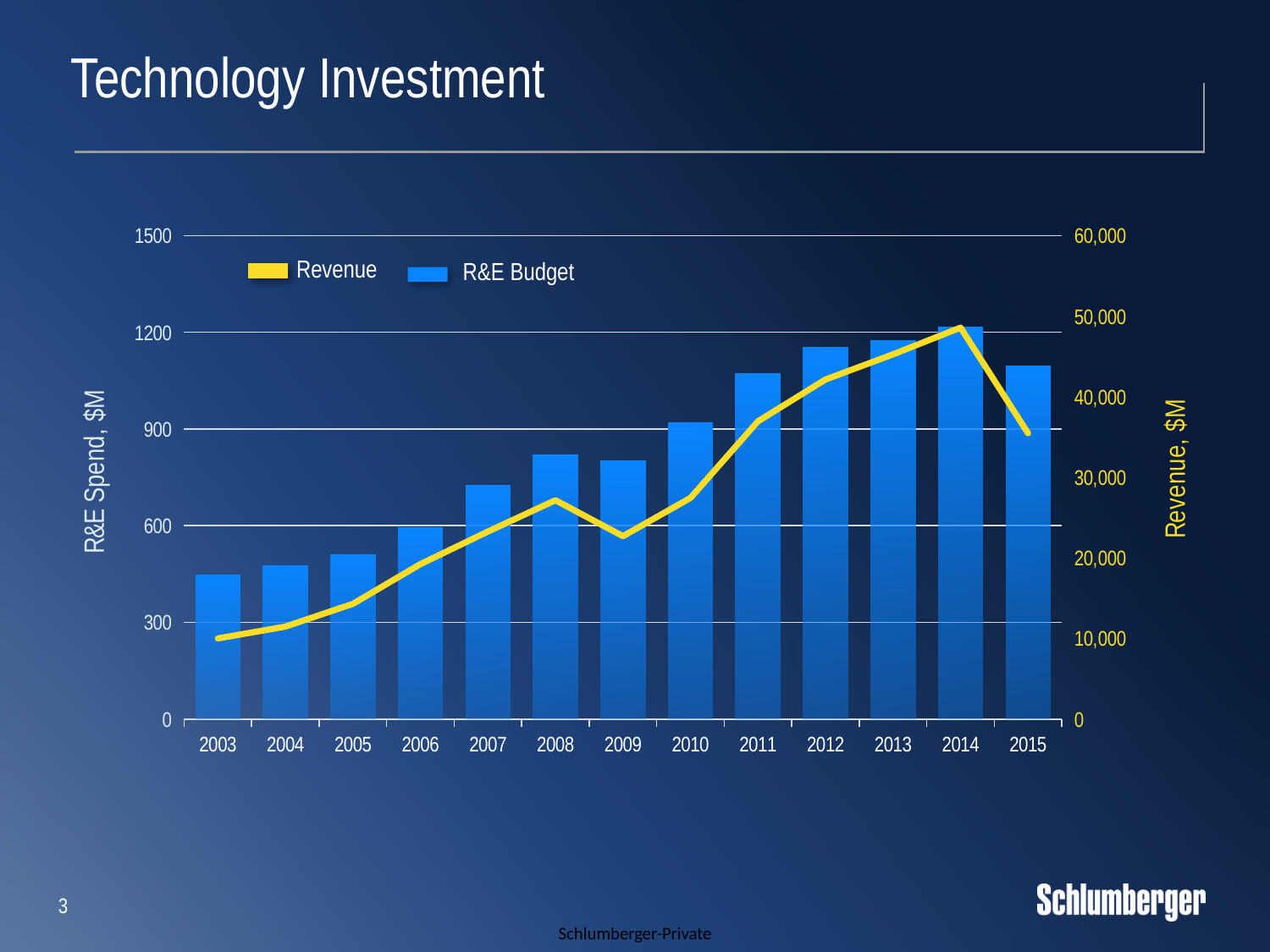
Is the Revenue value for 2015 greater or less than 40,000? less Is the Revenue value for 2009 greater or less than 30,000? less Which year has the larger R&E Budget, 2010 or 2011? 2011 How many years are shown on the x axis of the chart? 13 What kind of chart is shown on the slide? A combined bar and line chart How many series does the chart legend list? 2 Which year has the lowest R&E Budget bar? 2003 Does the Revenue line rise or fall from 2014 to 2015? fall Is the R&E Budget value for 2008 greater or less than 600? greater In which year does the Revenue line reach its highest point? 2014 What is the title of the chart on the slide? Technology Investment Which year has the highest R&E Budget bar? 2014